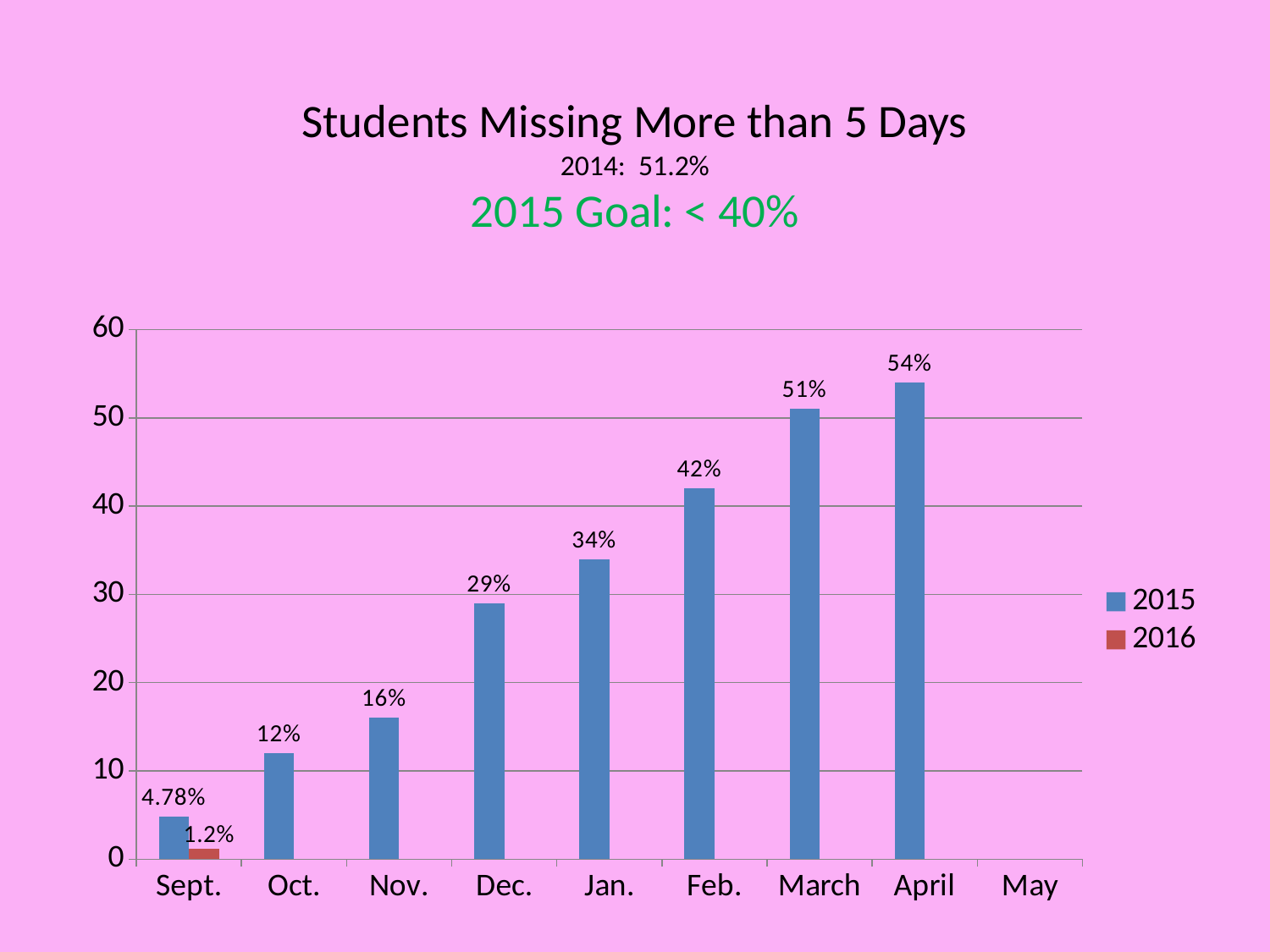
What kind of chart is shown? bar chart Which is larger, the 2015 value for Dec. or the 2015 value for Jan.? Jan. How many months are shown on the x axis? 9 Which month has the lowest 2015 value? Sept. Which month has the highest 2015 value? April Do the 2015 values rise or fall from Sept. to April? rise How many series does the legend list? 2 What is the 2015 value for April? 54% What is the 2016 value for Sept.? 1.2% What is the difference between the 2015 values for April and March? 3% Is the 2015 value for Feb. greater or less than 40? greater What is the 2015 value for Sept.? 4.78%